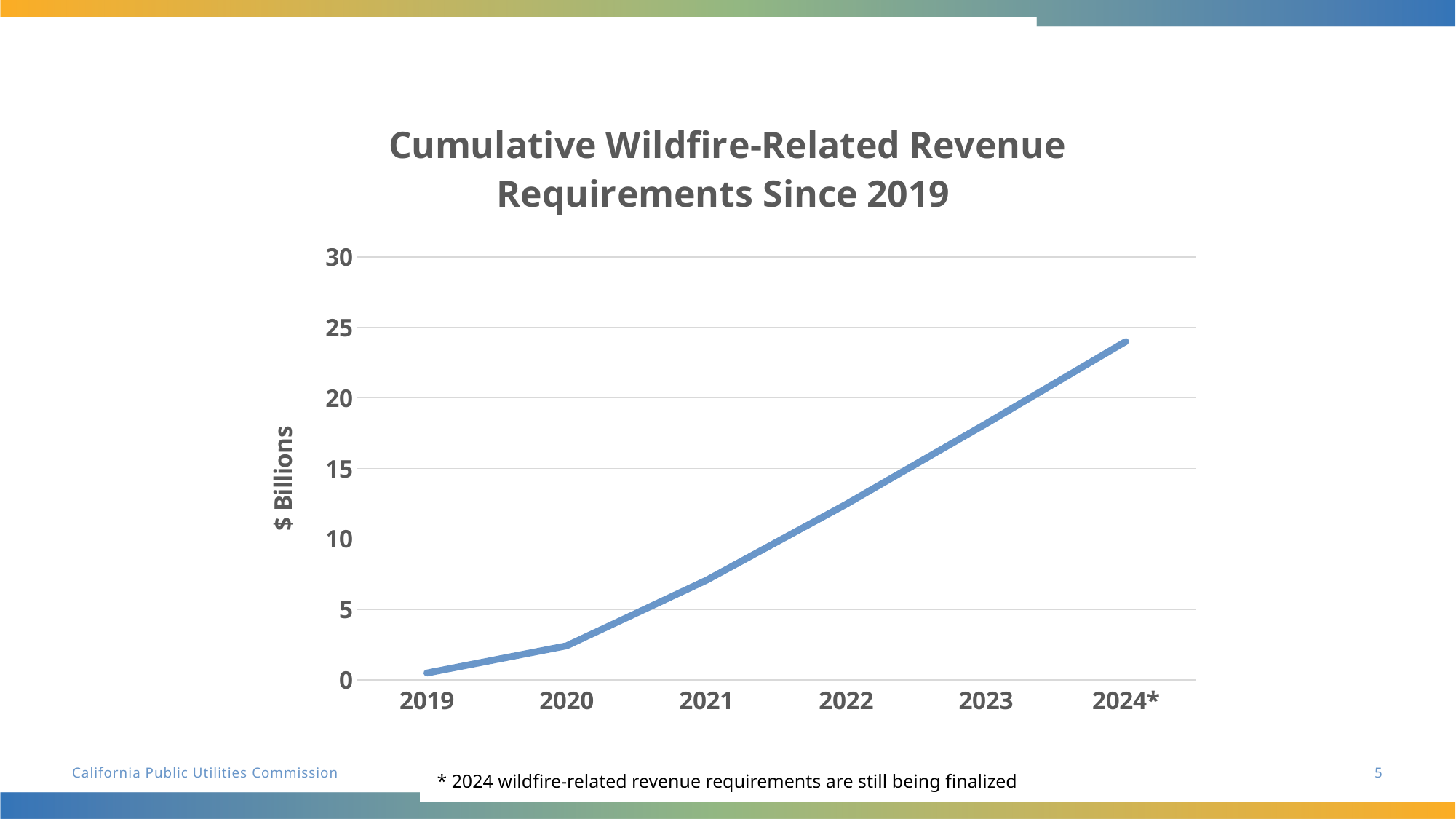
Which is larger, the value for 2023 or the value for 2021? 2023 Is the value for 2020 greater or less than 5? less Is the value for 2024* greater or less than 20? greater What is the title of the chart? Cumulative Wildfire-Related Revenue Requirements Since 2019 Is the value for 2021 greater or less than 5? greater What kind of chart is shown on the slide? line chart What is the label on the vertical axis of the chart? $ Billions Which year has the highest cumulative wildfire-related revenue requirement? 2024* How many years are plotted along the x axis of the chart? 6 Which year has the lowest cumulative wildfire-related revenue requirement? 2019 Do the values rise or fall from 2019 to 2024*? rise